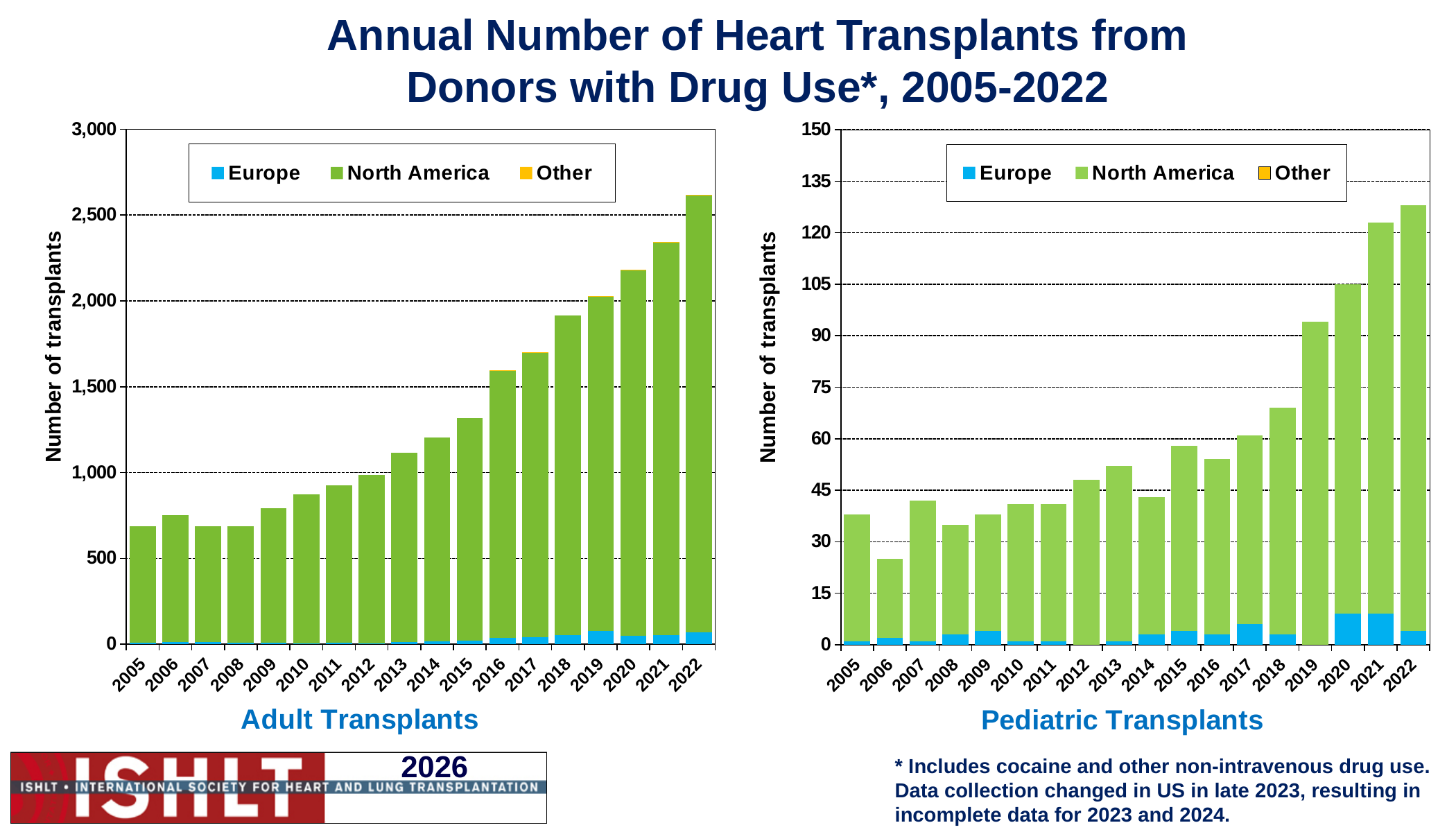
What type of chart is the Adult Transplants chart? stacked bar chart In the Pediatric Transplants chart, which year has the lowest total number of transplants? 2006 In the Adult Transplants chart, what is the overall trend in the number of transplants from 2008 to 2022? rising How many series does the legend of the Pediatric Transplants chart list? 3 In the Pediatric Transplants chart, which year has a larger total, 2007 or 2008? 2007 How many years are shown on the x axis of the Adult Transplants chart? 18 In the Adult Transplants chart, is the total for 2005 greater or less than 1,000? less In the Adult Transplants chart, which year has the highest total number of transplants? 2022 In the Pediatric Transplants chart, which year has the highest total number of transplants? 2022 In the Pediatric Transplants chart, is the total for 2018 greater or less than 60? greater In the Adult Transplants chart, is the total for 2022 greater or less than 2,500? greater